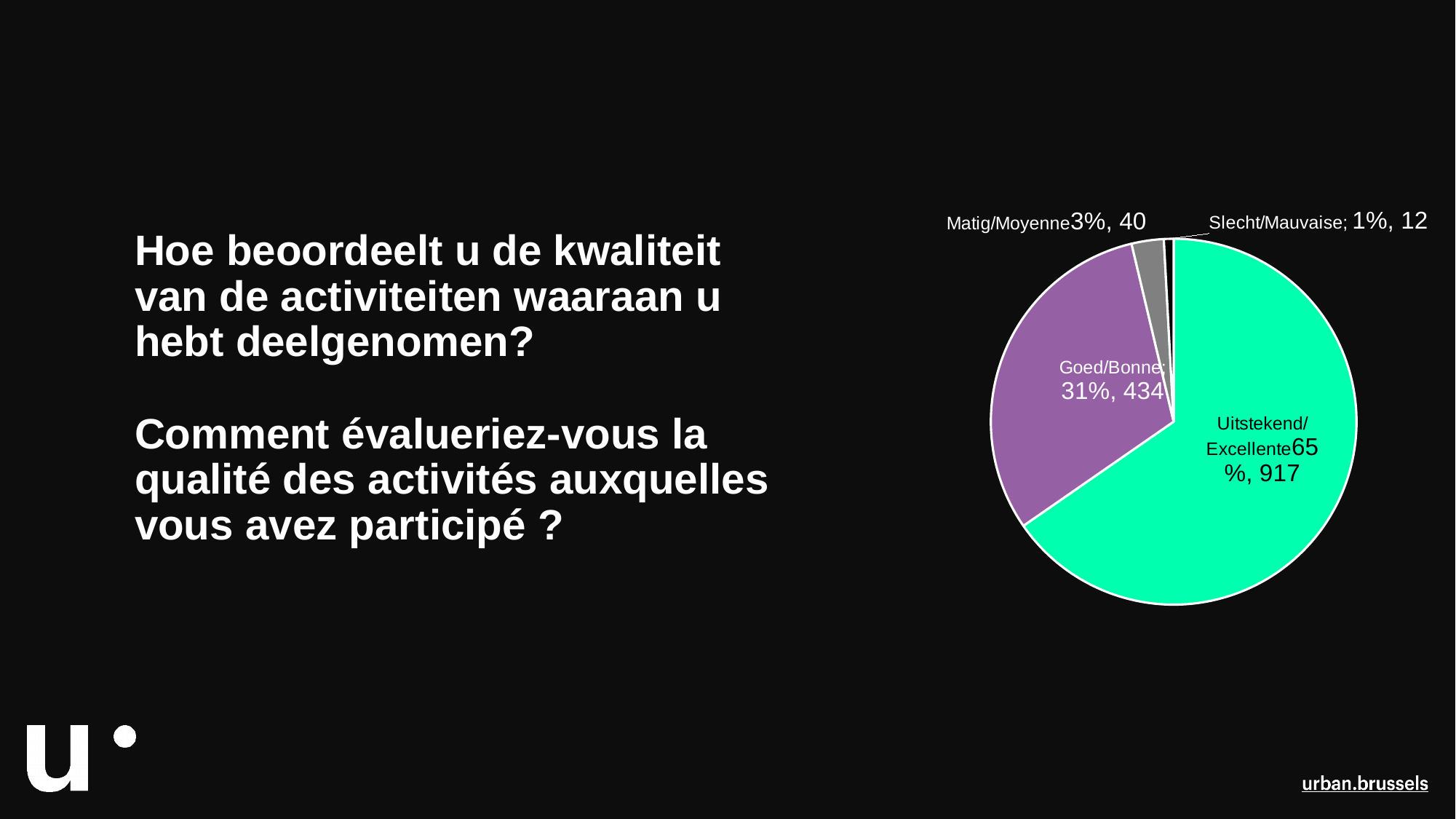
What is the difference in count between Uitstekend/Excellente and Goed/Bonne? 483 What percentage share does the Uitstekend/Excellente slice have? 65% What is the count shown for Slecht/Mauvaise? 12 What kind of chart is shown on the slide? pie chart What is the count shown for Goed/Bonne? 434 Which is larger, the count for Matig/Moyenne or the count for Slecht/Mauvaise? Matig/Moyenne Which category has the smallest slice? Slecht/Mauvaise What colour is the Goed/Bonne slice? purple Which category has the largest slice? Uitstekend/Excellente How many slices does the pie chart have? 4 What percentage share does the Goed/Bonne slice have? 31% What is the count shown for Matig/Moyenne? 40